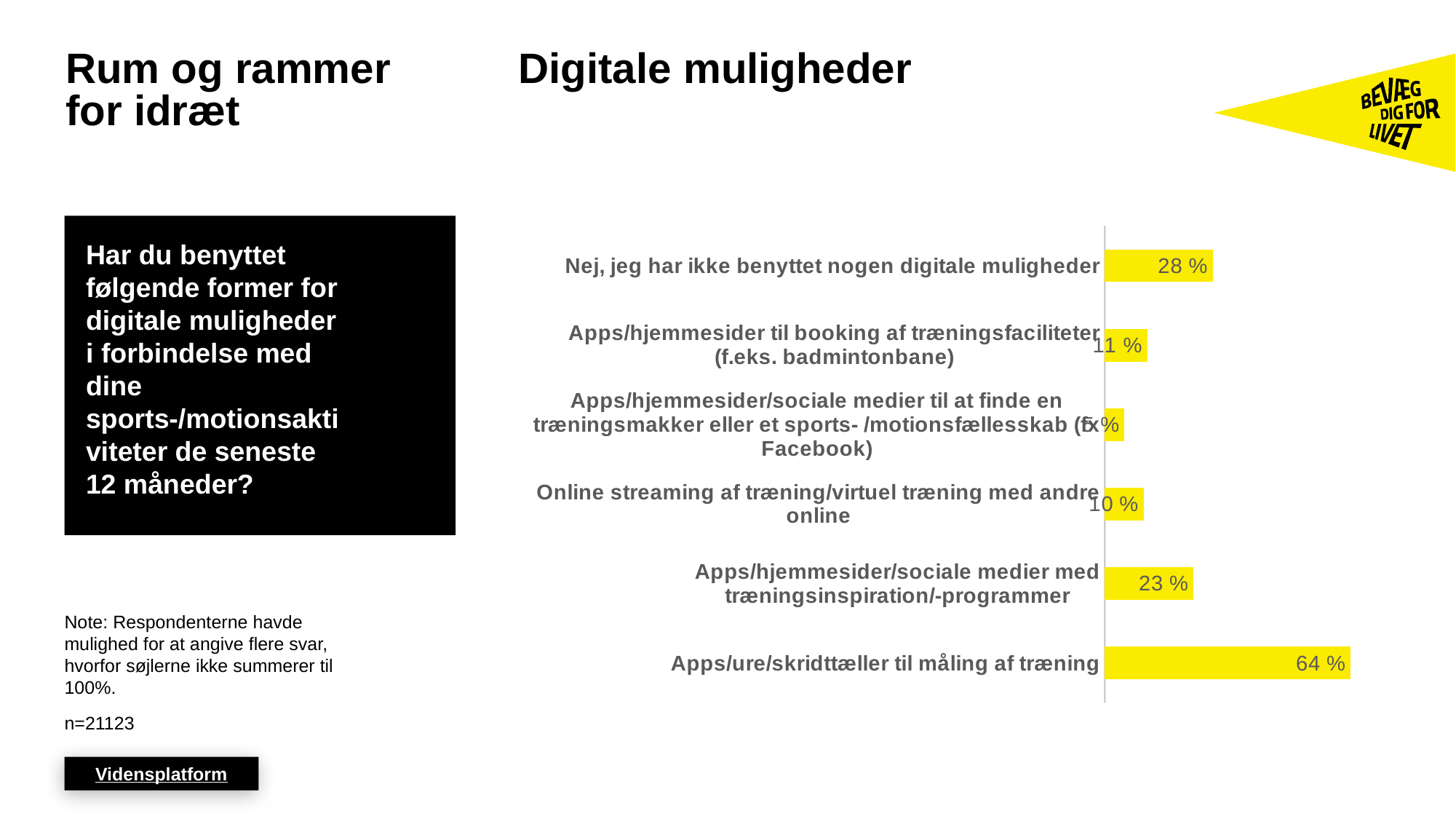
Which category has the highest value? Apps/ure/skridttæller til måling af træning How many categories does the chart show? 6 What colour are the bars in the chart? Yellow What is the value for "Apps/hjemmesider/sociale medier med træningsinspiration/-programmer"? 23 % What kind of chart is shown on the slide? Bar chart Which category has the lowest value? Apps/hjemmesider/sociale medier til at finde en træningsmakker eller et sports- /motionsfællesskab (fx Facebook) What is the value for "Apps/hjemmesider til booking af træningsfaciliteter (f.eks. badmintonbane)"? 11 % What is the value for "Apps/ure/skridttæller til måling af træning"? 64 % What is the difference between the values for "Apps/ure/skridttæller til måling af træning" and "Nej, jeg har ikke benyttet nogen digitale muligheder"? 36 % What is the value for "Nej, jeg har ikke benyttet nogen digitale muligheder"? 28 % What is the value for "Online streaming af træning/virtuel træning med andre online"? 10 % Which is larger: the value for "Apps/hjemmesider/sociale medier med træningsinspiration/-programmer" or the value for "Apps/hjemmesider til booking af træningsfaciliteter (f.eks. badmintonbane)"? Apps/hjemmesider/sociale medier med træningsinspiration/-programmer